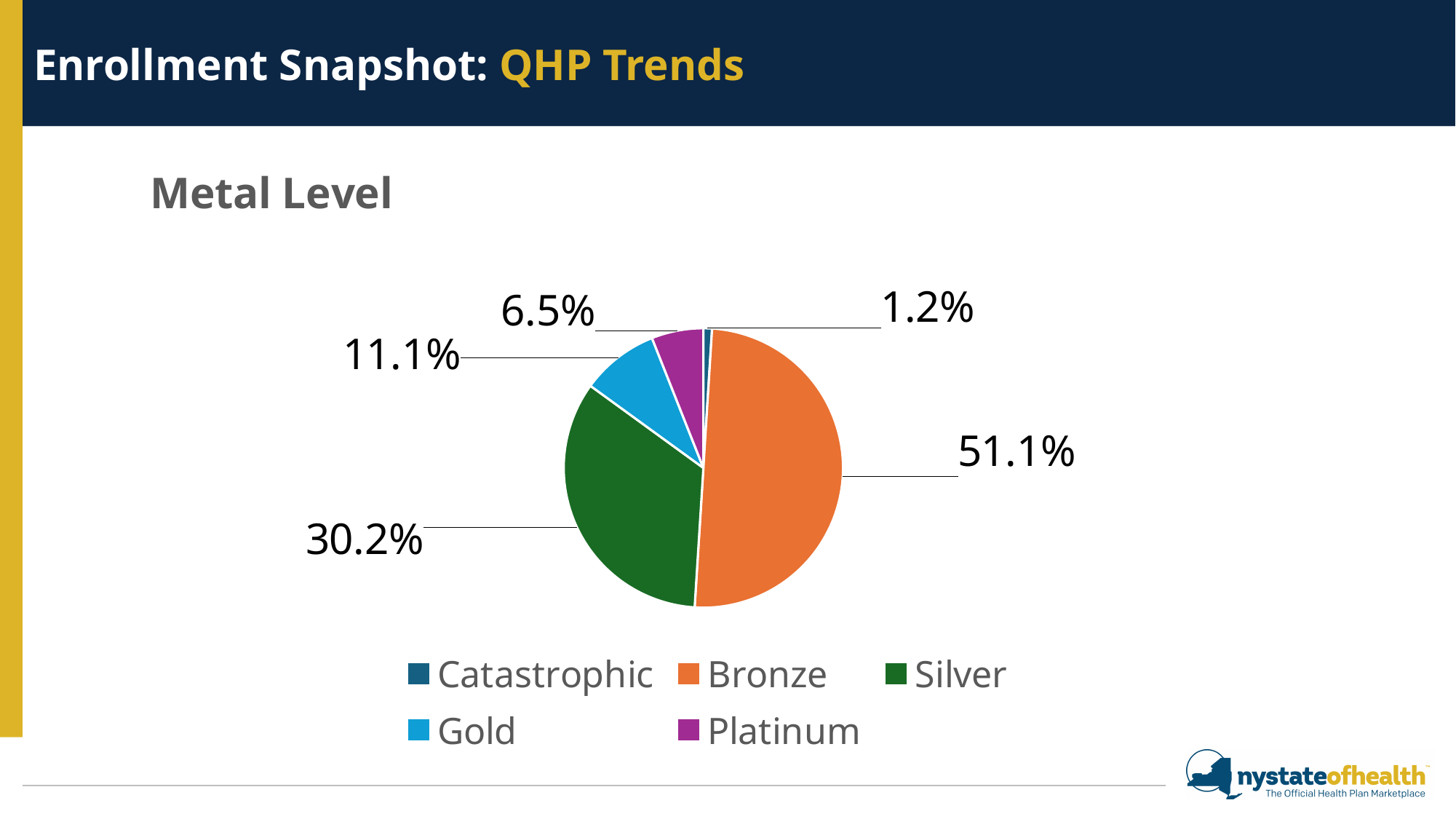
What is the value for Gold? 11.1% Which metal level has the largest share of the pie? Bronze Which is larger, Gold or Platinum? Gold What kind of chart is shown on the slide? Pie chart What percentage is shown for Silver? 30.2% What is the value for Catastrophic? 1.2% What is the title of the chart? Metal Level What is the difference in percentage points between Bronze and Silver? 20.9 How many metal levels are shown in the pie chart? 5 Which metal level has the smallest share of the pie? Catastrophic What percentage is shown for Platinum? 6.5% What share of the pie does Bronze represent? 51.1%